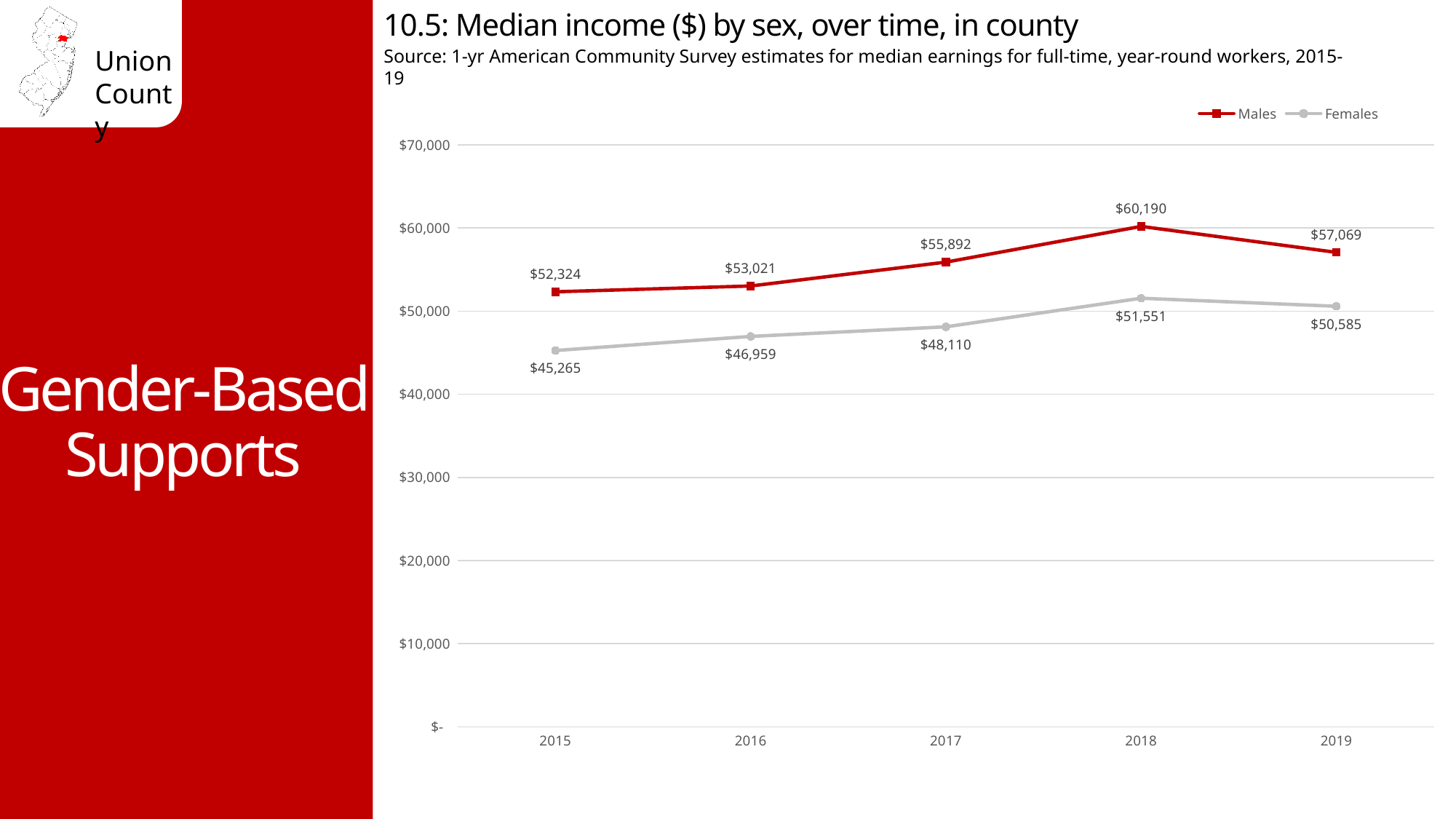
How many series does the legend list? 2 What is the difference between the Males and Females median income in 2017? $7,782 Does the Females median income rise or fall from 2015 to 2018? Rise What is the median income for Females in 2019? $50,585 In which year is the median income for Females lowest? 2015 What is the median income for Males in 2018? $60,190 What colour is the Males line? Red How many years are shown on the x axis? 5 Which is larger, the Males median income in 2016 or the Females median income in 2018? Males median income in 2016 What kind of chart is shown on the slide? Line chart In which year is the median income for Males highest? 2018 What is the median income for Females in 2015? $45,265